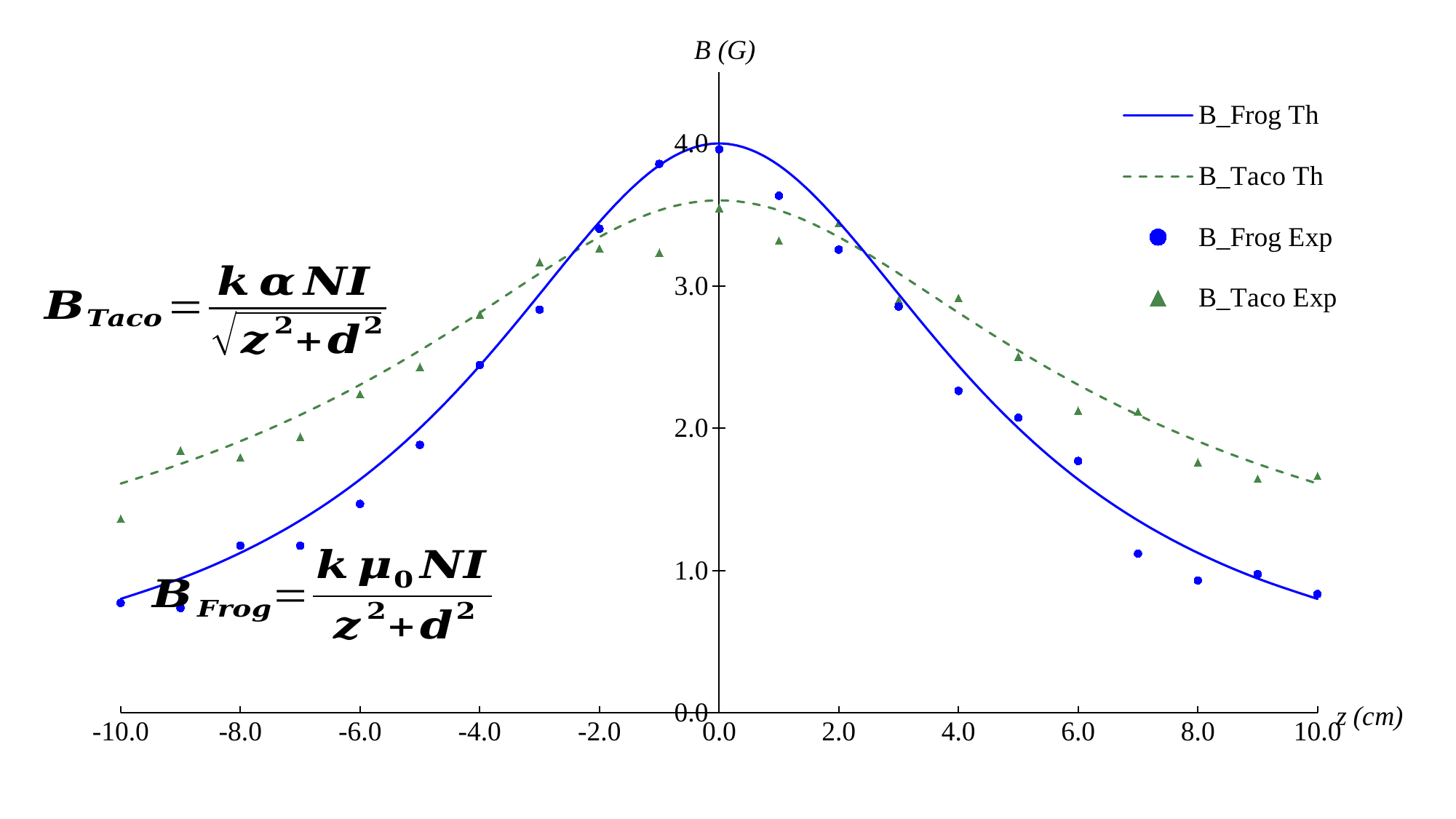
Is the B_Frog Exp value at z = 0.0 greater or less than 3.0? greater At which z value does B_Frog Exp reach its highest point? 0.0 What kind of chart is shown on the slide? line chart Is the B_Frog Exp value at z = 10.0 greater or less than 1.0? less Is the B_Frog Exp value at z = -6.0 greater or less than 2.0? less How many series does the legend list? 4 What is the label of the x axis? z (cm) At z = 8.0, which is larger, B_Frog Exp or B_Taco Exp? B_Taco Exp From z = 0.0 to z = 10.0, does the B_Frog Th curve rise or fall? fall Which series is drawn as a dashed line? B_Taco Th At z = 0.0, which is larger, B_Frog Exp or B_Taco Exp? B_Frog Exp